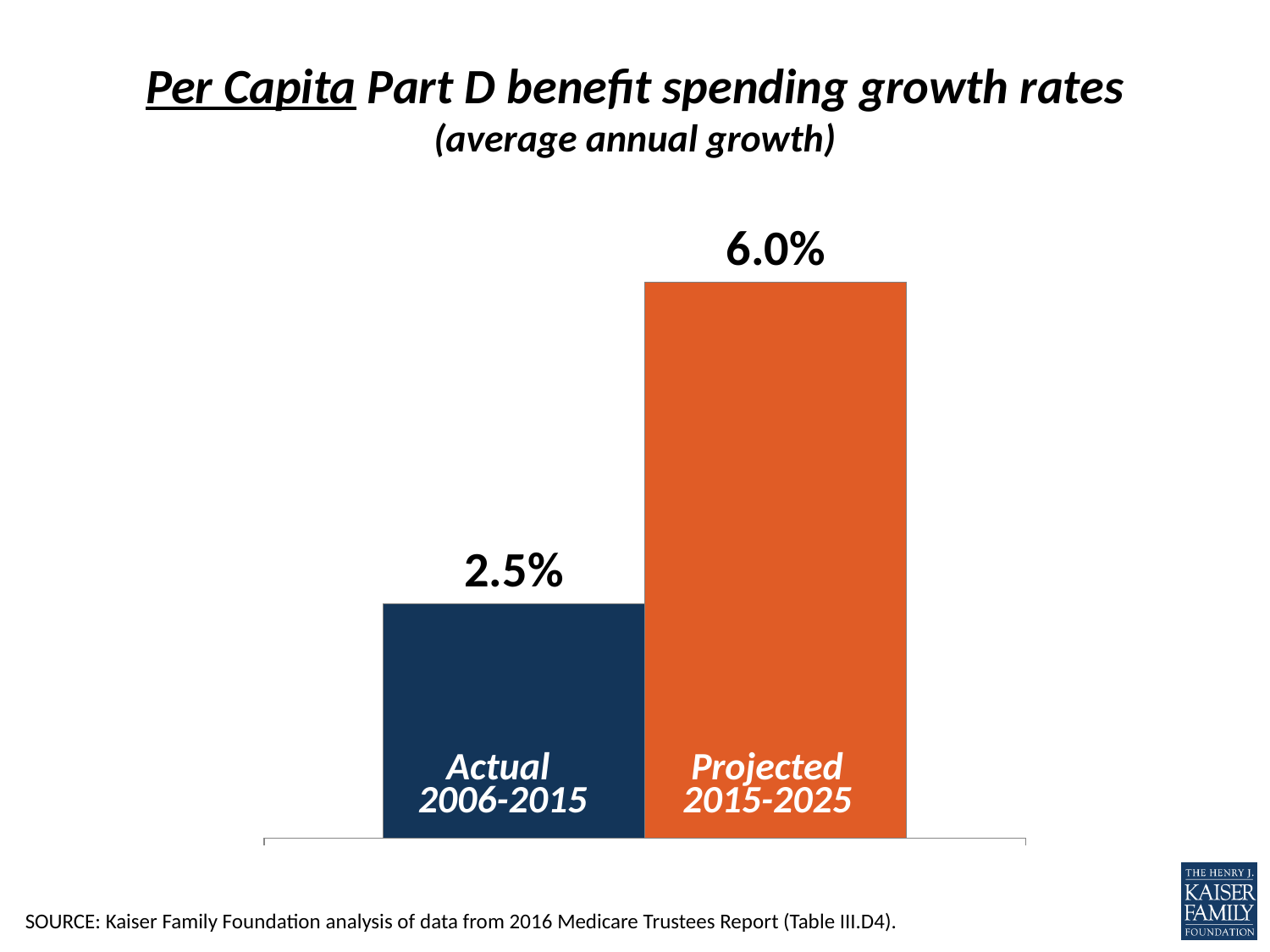
What is the title of the chart? Per Capita Part D benefit spending growth rates (average annual growth) Do the values rise or fall from the Actual 2006-2015 bar to the Projected 2015-2025 bar? rise Which period has the lower per capita Part D benefit spending growth rate? Actual 2006-2015 Is the growth rate for Actual 2006-2015 larger or smaller than the growth rate for Projected 2015-2025? smaller What colour is the bar for Projected 2015-2025? orange Which period has the higher per capita Part D benefit spending growth rate? Projected 2015-2025 What type of chart is shown on the slide? bar chart How many bars are shown in the chart? 2 What is the average annual per capita Part D benefit spending growth rate for Actual 2006-2015? 2.5% What is the difference in percentage points between the Projected 2015-2025 and Actual 2006-2015 growth rates? 3.5 percentage points What is the average annual per capita Part D benefit spending growth rate for Projected 2015-2025? 6.0%